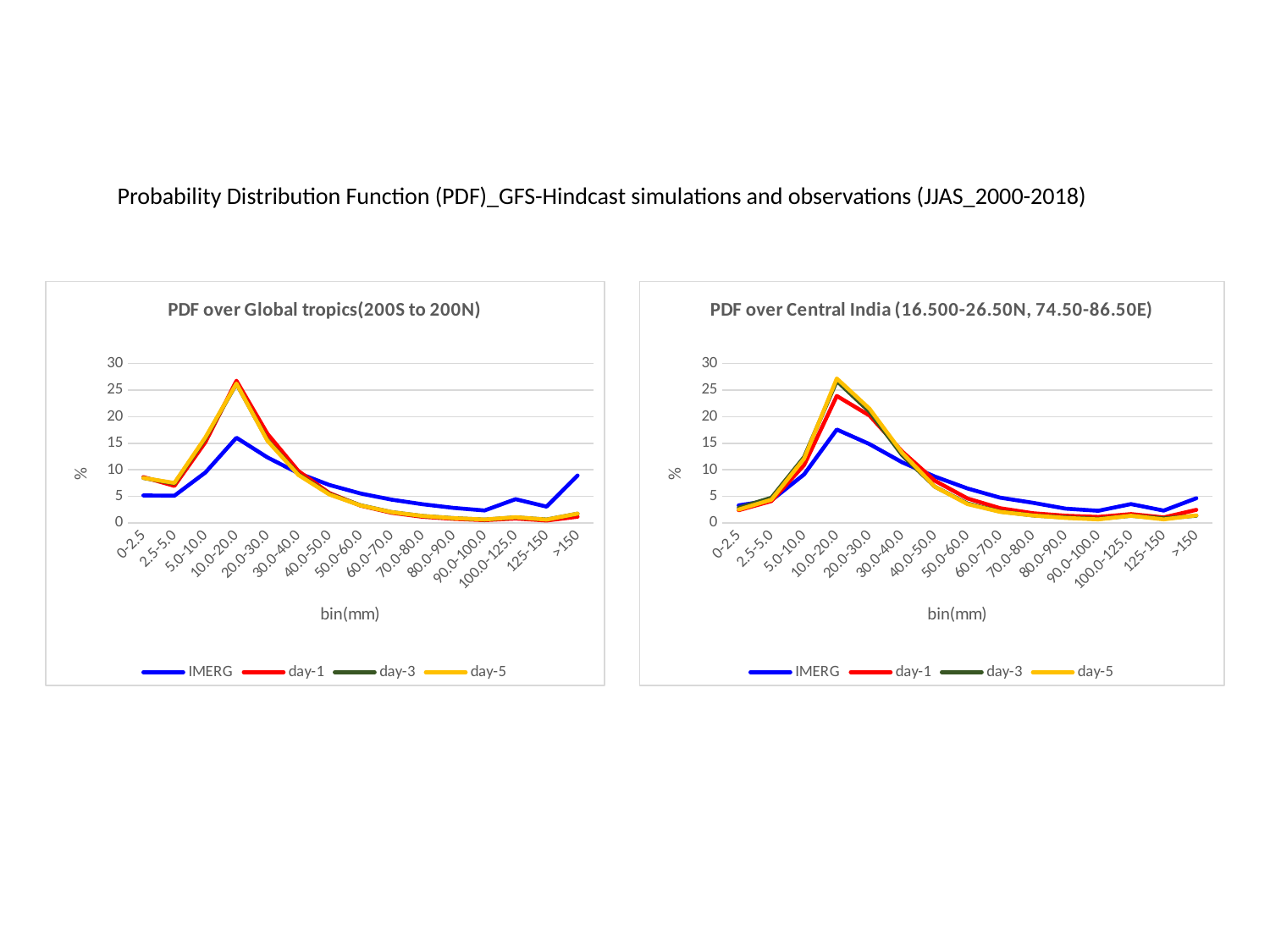
In the 'PDF over Global tropics(200S to 200N)' chart, at which bin does the day-1 series reach its highest value? 10.0-20.0 In the 'PDF over Central India' chart, is the IMERG value at the 10.0-20.0 bin greater or less than 15? greater In the 'PDF over Central India' chart, at which bin does the IMERG series reach its highest value? 10.0-20.0 In the 'PDF over Global tropics(200S to 200N)' chart, which is larger at the >150 bin: IMERG or day-1? IMERG In the 'PDF over Global tropics(200S to 200N)' chart, which is larger at the 10.0-20.0 bin: IMERG or day-1? day-1 How many series does the legend of the 'PDF over Central India' chart list? 4 What colour is the IMERG series in the charts? blue In the 'PDF over Central India' chart, is the day-5 value at the 60.0-70.0 bin greater or less than 5? less How many bins are shown on the x axis of the 'PDF over Global tropics(200S to 200N)' chart? 15 In the 'PDF over Central India' chart, does the IMERG series rise or fall from the 10.0-20.0 bin to the 90.0-100.0 bin? fall In the 'PDF over Global tropics(200S to 200N)' chart, is the day-1 value at the 10.0-20.0 bin greater or less than 25? greater What kind of chart is the 'PDF over Global tropics(200S to 200N)' chart? line chart